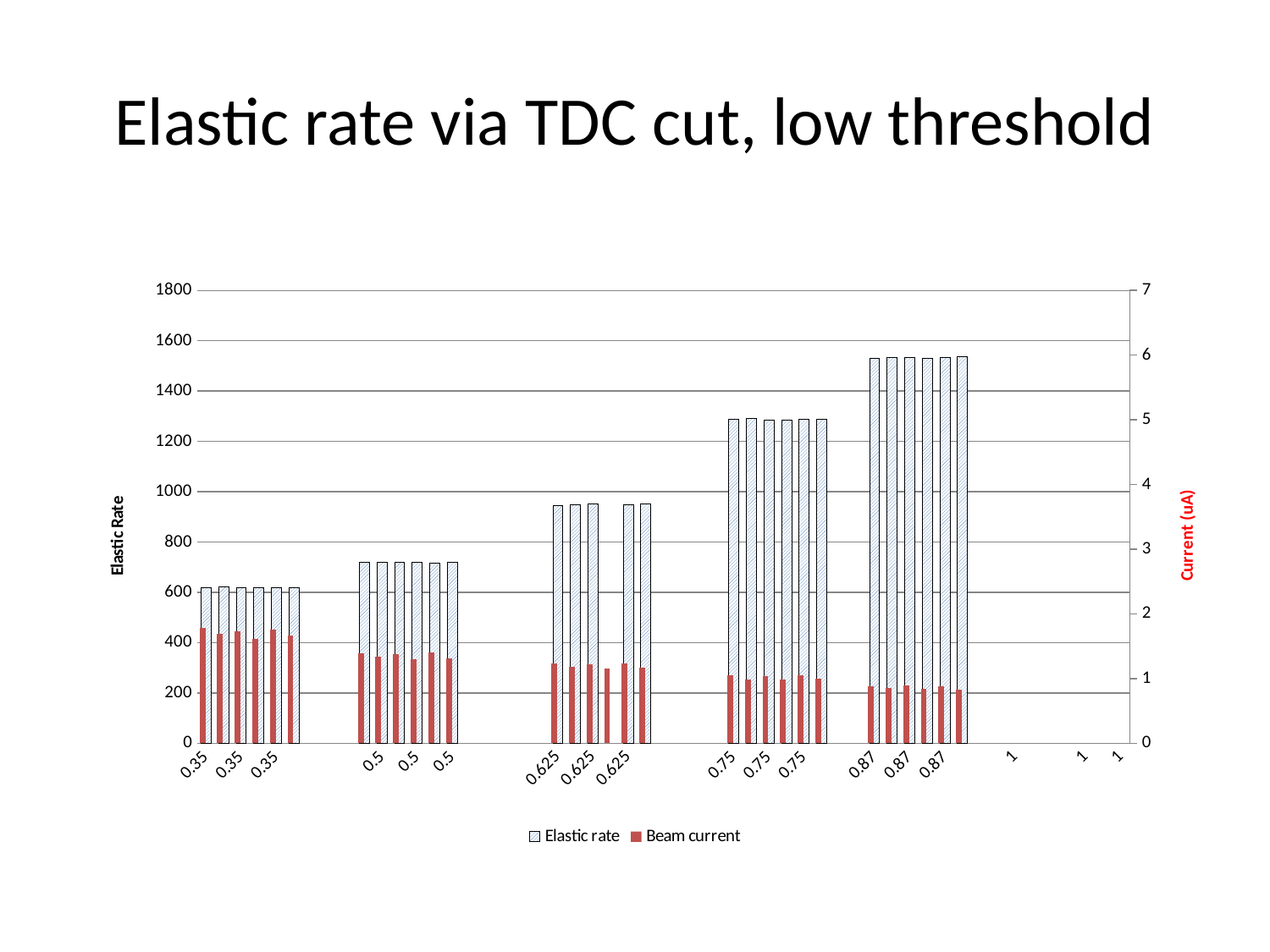
Among the groups with bars, at which x-axis value is the Elastic rate lowest? 0.35 Is the Elastic rate at x = 0.5 greater or less than 800? less Is the Elastic rate at x = 0.87 greater or less than 1400? greater Which has the larger Beam current, the group at x = 0.35 or the group at x = 0.87? 0.35 Is the Elastic rate at x = 0.625 greater or less than 1000? less What are the two series named in the legend? Elastic rate and Beam current What kind of chart is shown on the slide? bar chart What is the title of the right-hand vertical axis? Current (uA) At which x-axis value is the Elastic rate highest? 0.87 Does the Elastic rate rise or fall as the x-axis value increases from 0.35 to 0.87? rise How many series does the legend list? 2